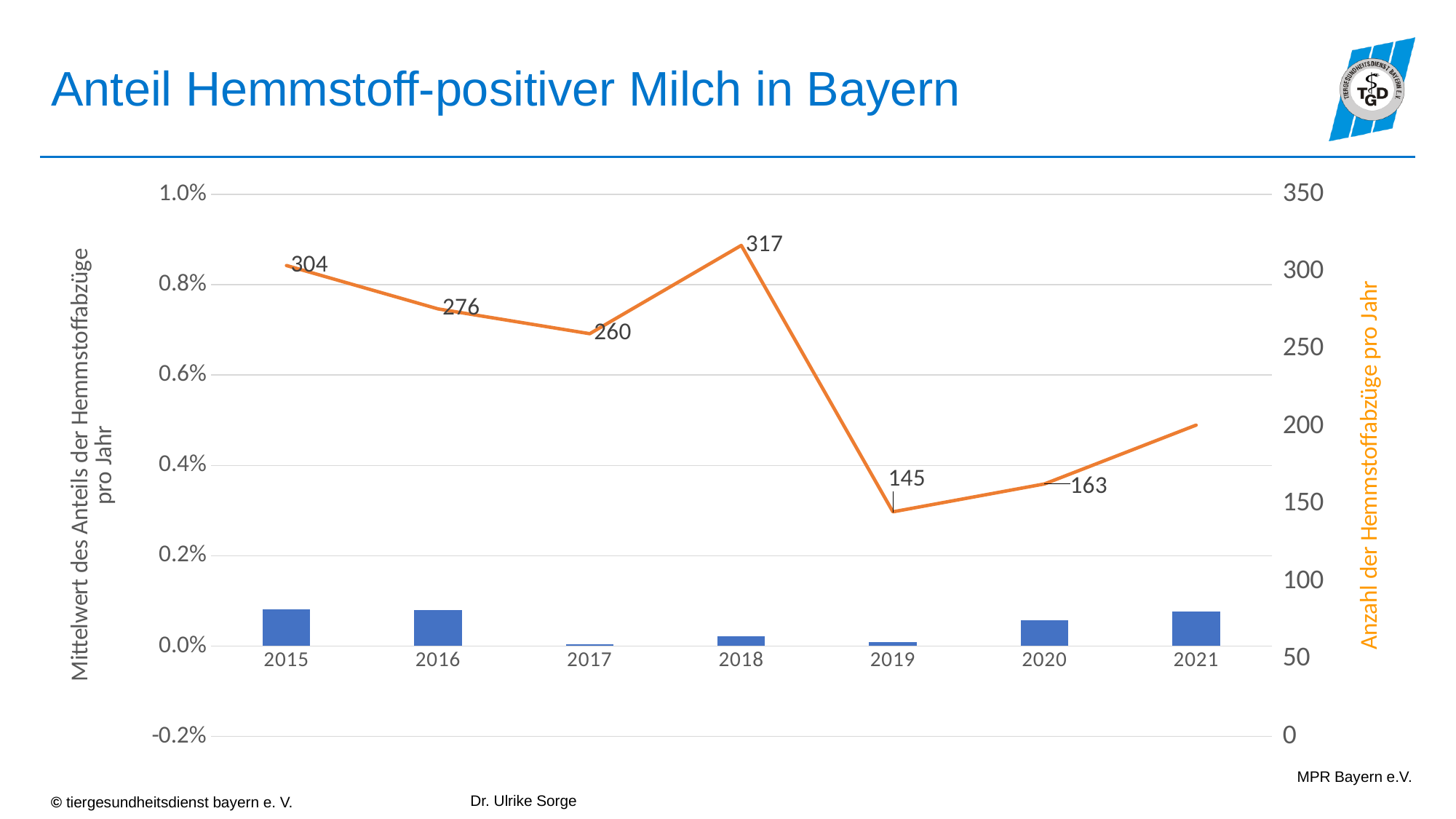
What is the value of the orange line (Anzahl der Hemmstoffabzüge pro Jahr) for 2018? 317 What is the value of the orange line (Anzahl der Hemmstoffabzüge pro Jahr) for 2019? 145 Is the blue bar for 2015 greater or less than 0.2%? less What is the value of the orange line for 2015? 304 In which year does the orange line (Anzahl der Hemmstoffabzüge pro Jahr) reach its highest value? 2018 What is the difference between the orange line values for 2018 and 2019? 172 Is the value of the orange line for 2021 greater or less than 250? less What kind of chart is shown on the slide? Combined bar and line chart What is the difference between the orange line values for 2015 and 2016? 28 In which year does the orange line (Anzahl der Hemmstoffabzüge pro Jahr) reach its lowest value? 2019 How many years are shown on the x axis of the chart? 7 Which year has the larger value on the orange line, 2016 or 2017? 2016